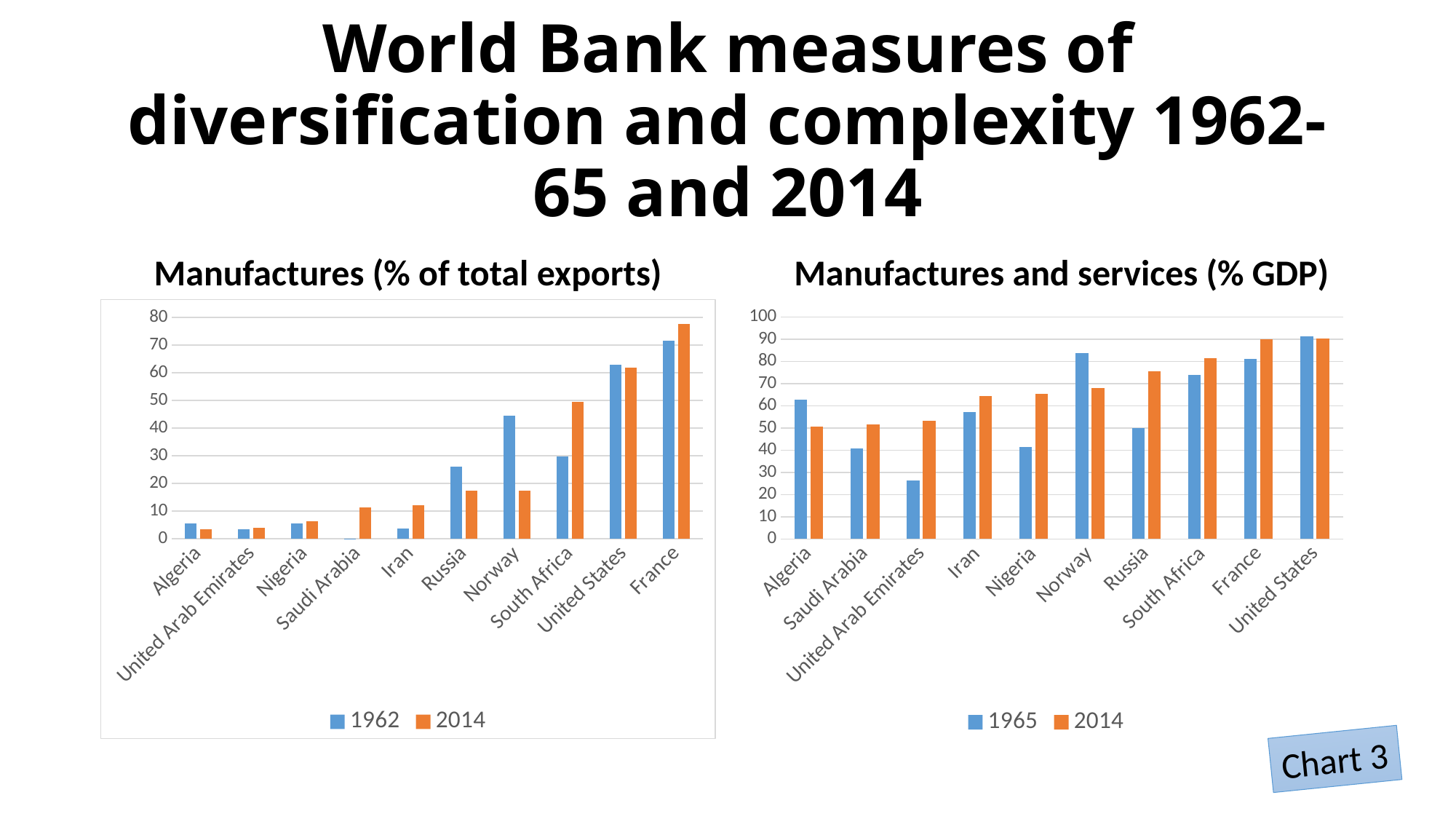
On the 'Manufactures (% of total exports)' chart, which country has the lowest 1962 value? Saudi Arabia On the 'Manufactures and services (% GDP)' chart, which country has the highest 1965 value? United States On the 'Manufactures and services (% GDP)' chart, which two years does the legend list? 1965 and 2014 On the 'Manufactures (% of total exports)' chart, which country has the highest 2014 value? France On the 'Manufactures and services (% GDP)' chart, is Algeria's 1965 value larger or smaller than its 2014 value? larger How many series does the legend of the 'Manufactures (% of total exports)' chart list? 2 On the 'Manufactures (% of total exports)' chart, is the 1962 value for United States greater or less than 60? greater How many countries are shown on the 'Manufactures and services (% GDP)' chart? 10 On the 'Manufactures and services (% GDP)' chart, which country has the lowest 1965 value? United Arab Emirates What kind of chart is the 'Manufactures (% of total exports)' chart? bar chart On the 'Manufactures and services (% GDP)' chart, is the 1965 value for Norway greater or less than 80? greater On the 'Manufactures (% of total exports)' chart, is Norway's 1962 value larger or smaller than its 2014 value? larger